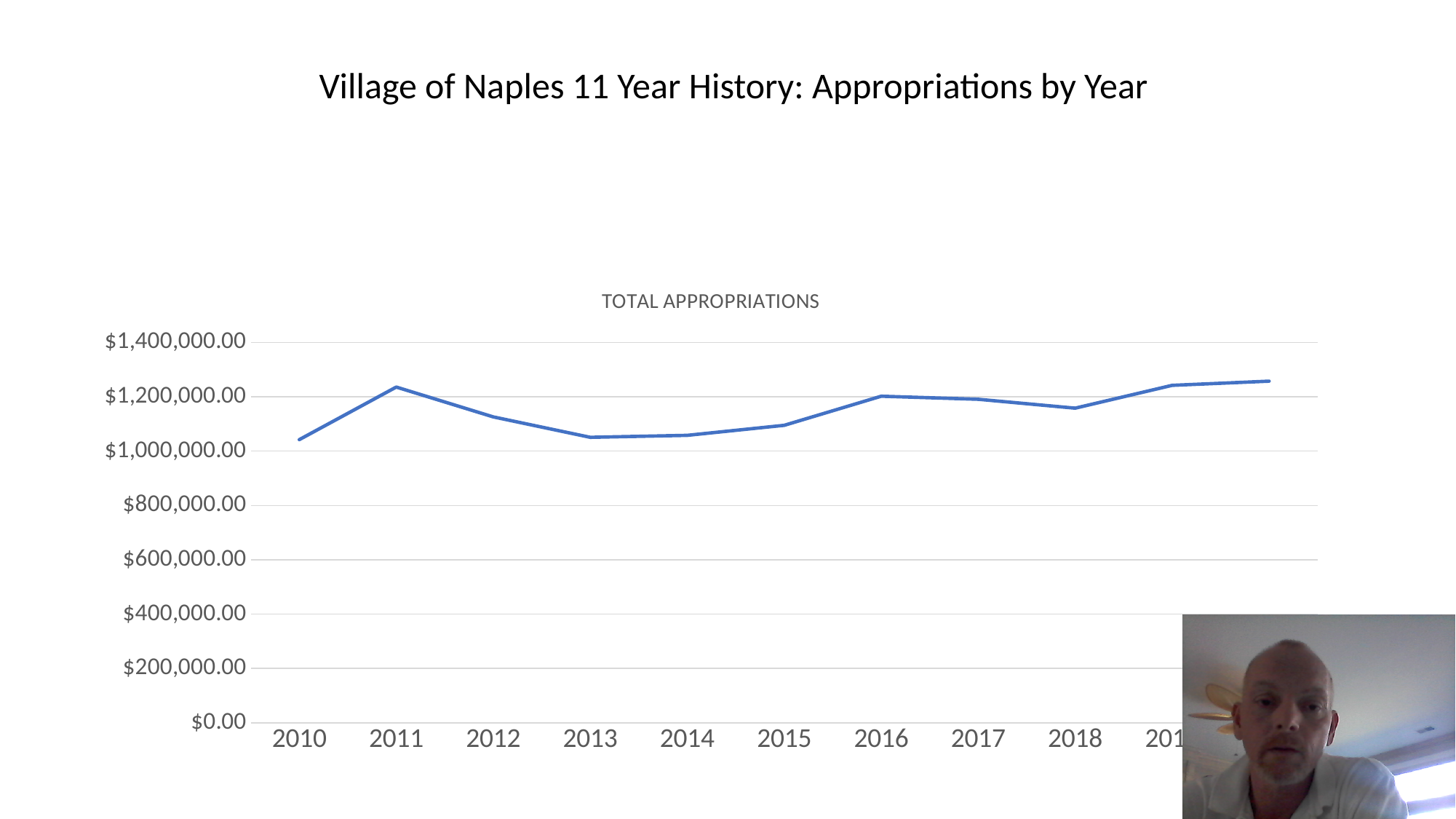
Is the value for 2011 greater or less than $1,200,000.00? greater What kind of chart is shown on the slide? line chart What is the title of the chart? TOTAL APPROPRIATIONS Do the values rise or fall from 2011 to 2013? fall Is the value for 2010 greater or less than $1,000,000.00? greater Which year has the larger value, 2013 or 2016? 2016 Which year has the larger value, 2011 or 2018? 2011 Is the value for 2018 greater or less than $1,200,000.00? less Do the values rise or fall from 2013 to 2016? rise Which year has the larger value, 2010 or 2011? 2011